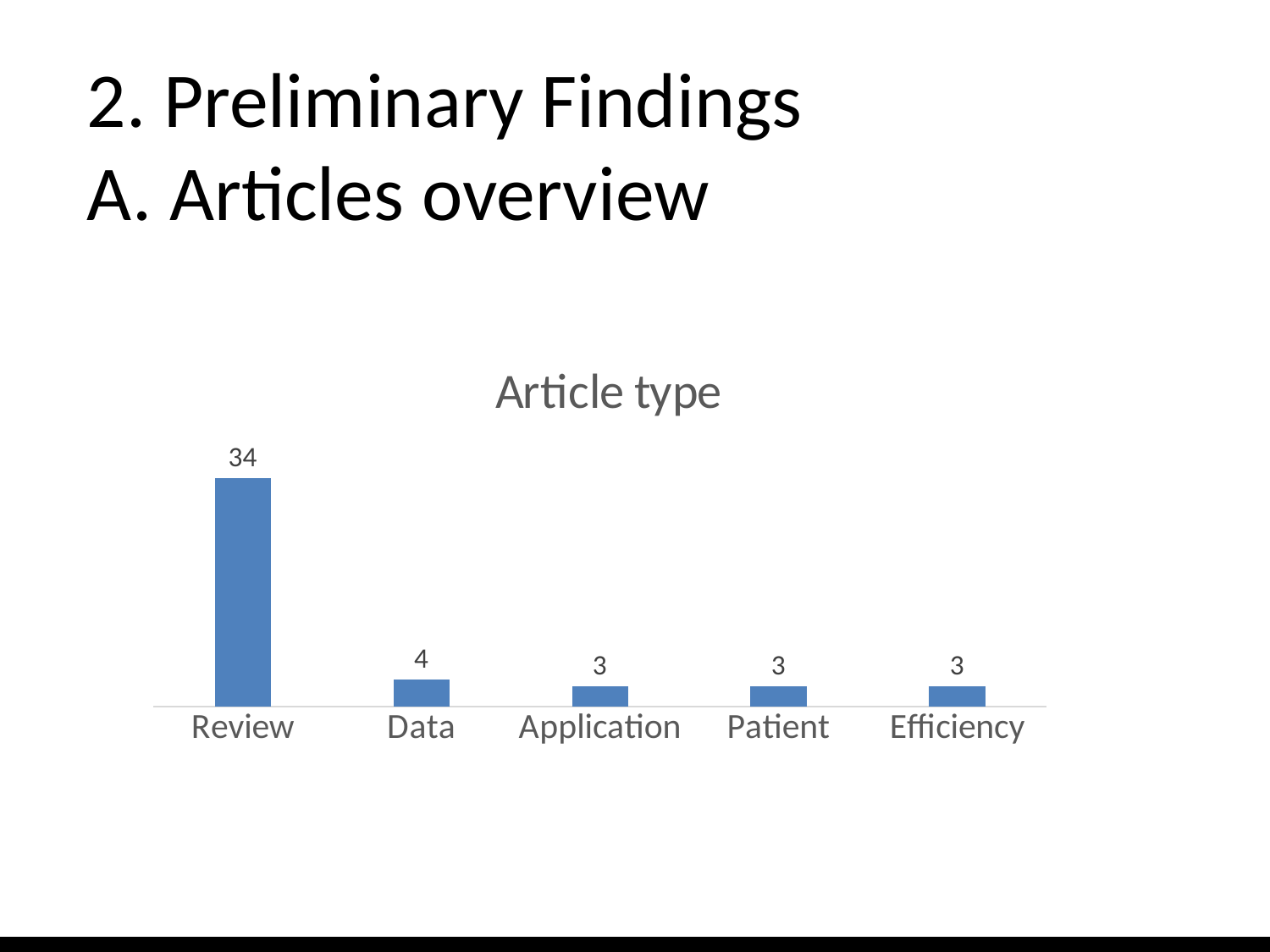
What is the title of the chart? Article type Which is larger, the value for Review or the value for Data? Review What is the total of all the values shown in the chart? 47 What is the value for Review? 34 What is the value for Data? 4 Which article type has the highest value? Review What kind of chart is shown on the slide? Bar chart What is the value for Efficiency? 3 What is the difference between the values for Data and Patient? 1 What is the difference between the values for Review and Data? 30 What is the value for Application? 3 How many article types are shown in the chart? 5